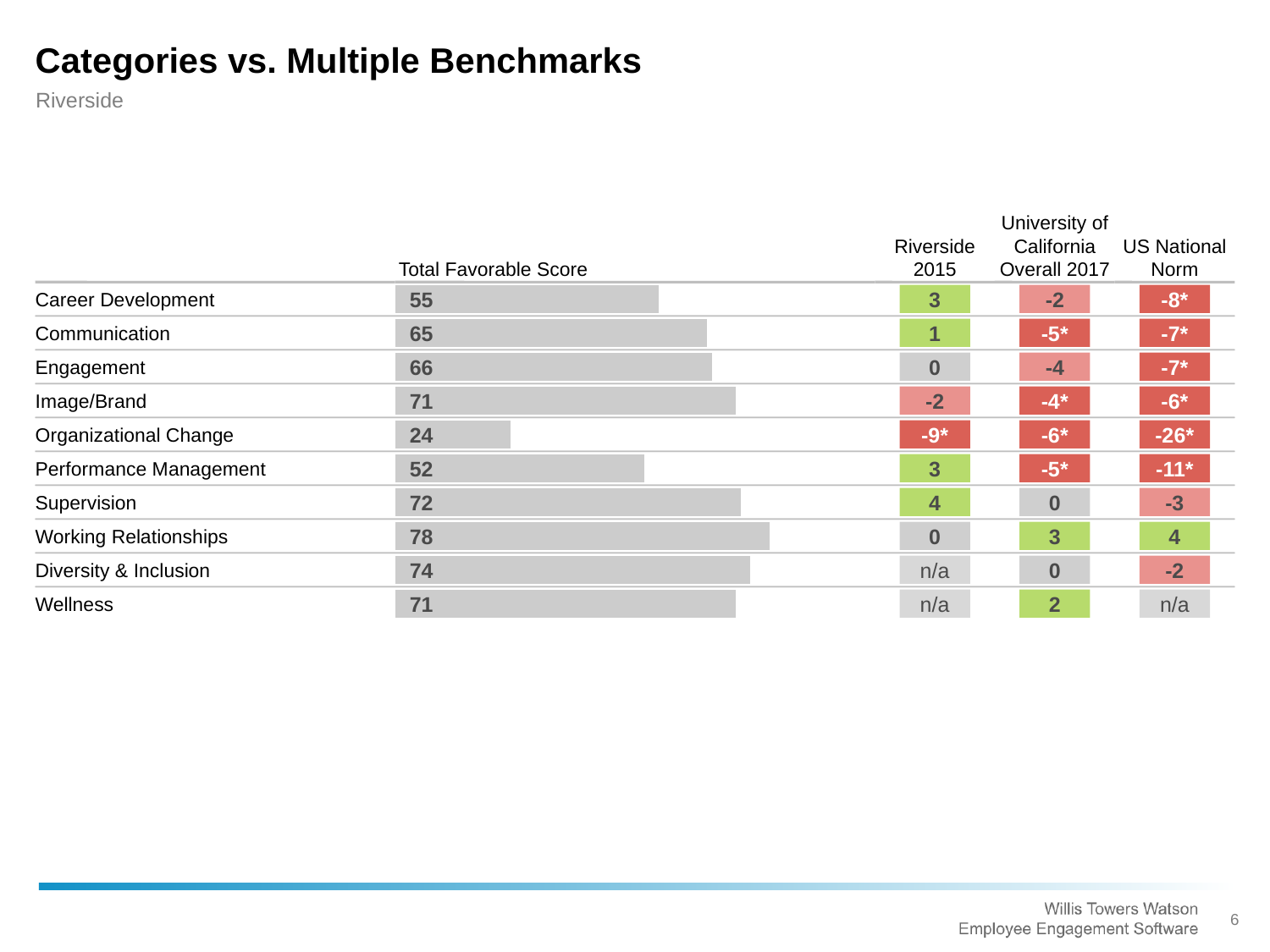
Which has a higher Total Favorable Score, Communication or Supervision? Supervision What is the difference between the Total Favorable Scores for Working Relationships and Organizational Change? 54 What is the difference versus University of California Overall 2017 for Wellness? 2 Which category has the lowest Total Favorable Score? Organizational Change What is the difference versus Riverside 2015 for Supervision? 4 What is the Total Favorable Score for Organizational Change? 24 What is the difference versus the US National Norm for Organizational Change? -26* Which category has the highest Total Favorable Score? Working Relationships How many categories are shown in the Total Favorable Score chart? 10 What is the title of the slide? Categories vs. Multiple Benchmarks What kind of chart is used to show the Total Favorable Score? Bar chart What is the Total Favorable Score for Career Development? 55